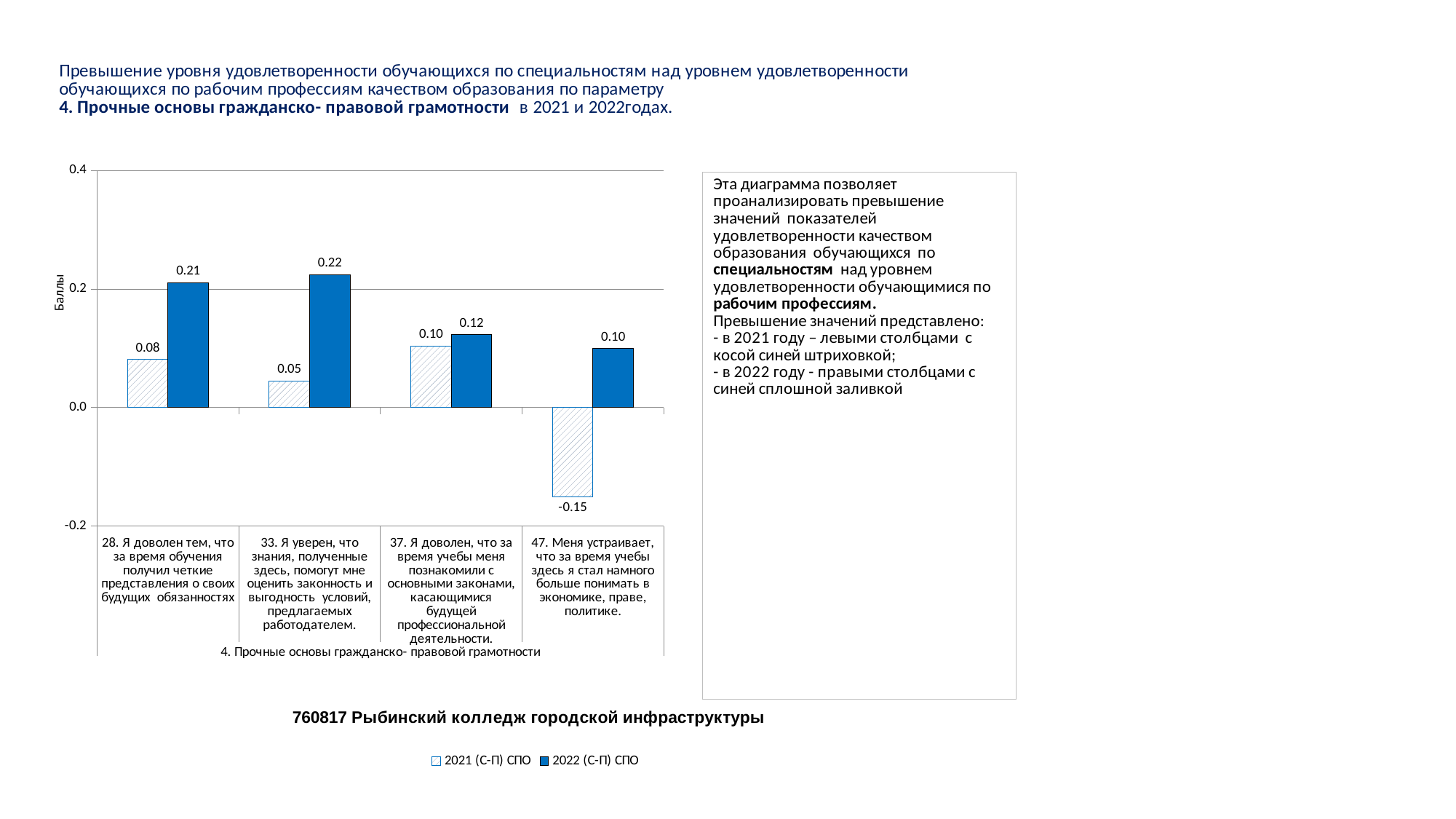
What is the difference between the 2022 (С-П) СПО and 2021 (С-П) СПО values for category 28? 0.13 Which category has the lowest value in the 2021 (С-П) СПО series? 47. Меня устраивает, что за время учебы здесь я стал намного больше понимать в экономике, праве, политике. For category 47, which series has the larger value: 2021 (С-П) СПО or 2022 (С-П) СПО? 2022 (С-П) СПО How many categories are shown on the x axis of the chart? 4 Is the 2022 (С-П) СПО value for category 33 greater or less than 0.2? greater What is the value of the 2022 (С-П) СПО series for category 33 (Я уверен, что знания, полученные здесь, помогут мне оценить законность и выгодность условий, предлагаемых работодателем)? 0.22 What type of chart is shown on the slide? bar chart What is the value of the 2021 (С-П) СПО series for category 28 (Я доволен тем, что за время обучения получил четкие представления о своих будущих обязанностях)? 0.08 Which category has the highest value in the 2022 (С-П) СПО series? 33. Я уверен, что знания, полученные здесь, помогут мне оценить законность и выгодность условий, предлагаемых работодателем. What is the value of the 2021 (С-П) СПО series for category 47 (Меня устраивает, что за время учебы здесь я стал намного больше понимать в экономике, праве, политике)? -0.15 How many series does the chart legend list? 2 What is the value of the 2022 (С-П) СПО series for category 37 (Я доволен, что за время учебы меня познакомили с основными законами, касающимися будущей профессиональной деятельности)? 0.12